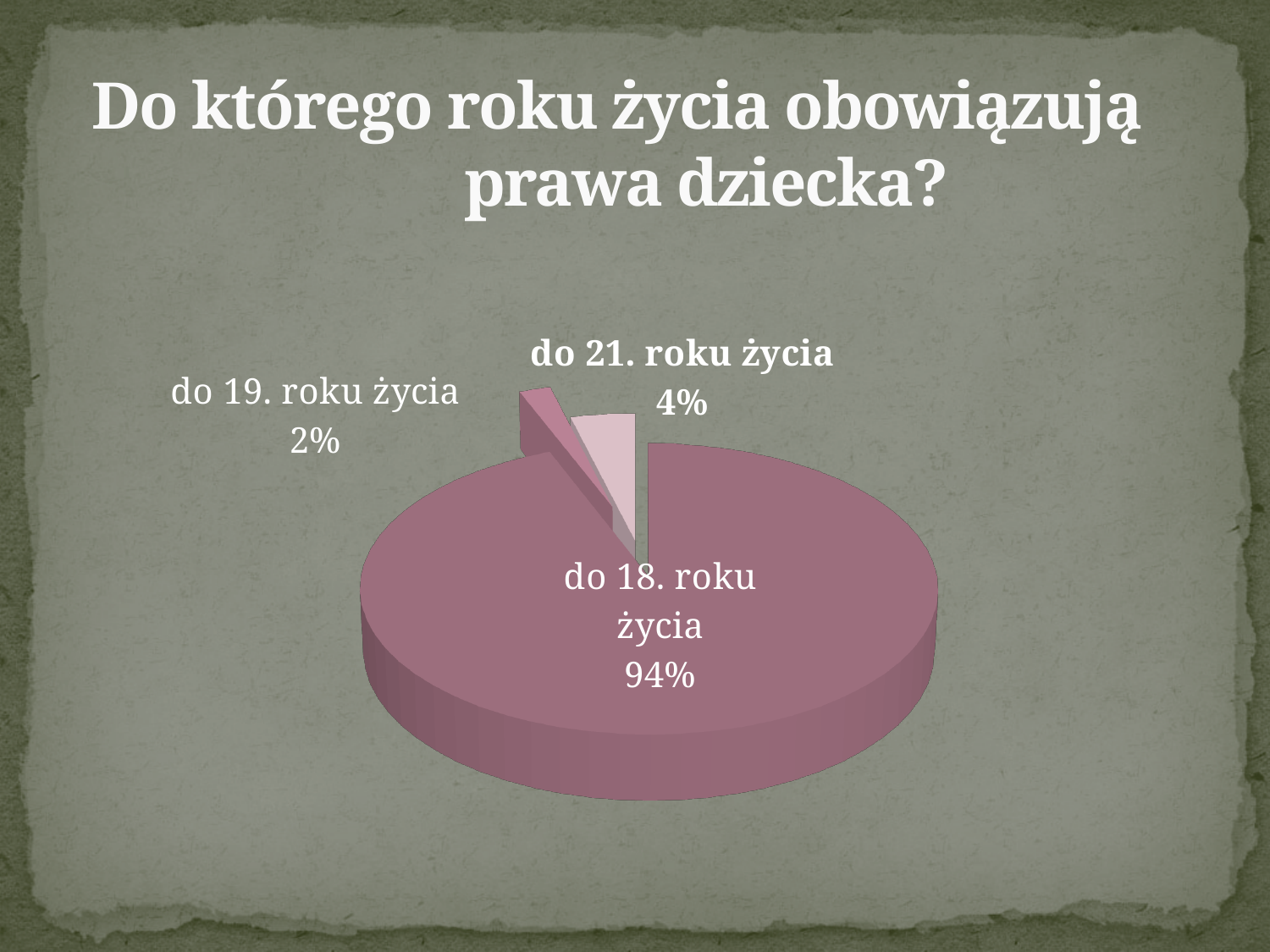
What kind of chart is shown on the slide? pie chart Which category has the largest slice of the pie? do 18. roku życia What is the title of the slide containing the chart? Do którego roku życia obowiązują prawa dziecka? Which is larger, the slice for "do 21. roku życia" or the slice for "do 19. roku życia"? do 21. roku życia What is the difference in percentage points between "do 21. roku życia" and "do 19. roku życia"? 2 How many slices does the pie chart have? 3 What share of the pie does "do 21. roku życia" have? 4% What is the difference in percentage points between "do 18. roku życia" and "do 21. roku życia"? 90 Which slice of the pie is shown in the lightest colour? do 21. roku życia What share of the pie does "do 19. roku życia" have? 2% Which category has the smallest slice of the pie? do 19. roku życia What share of the pie does "do 18. roku życia" have? 94%